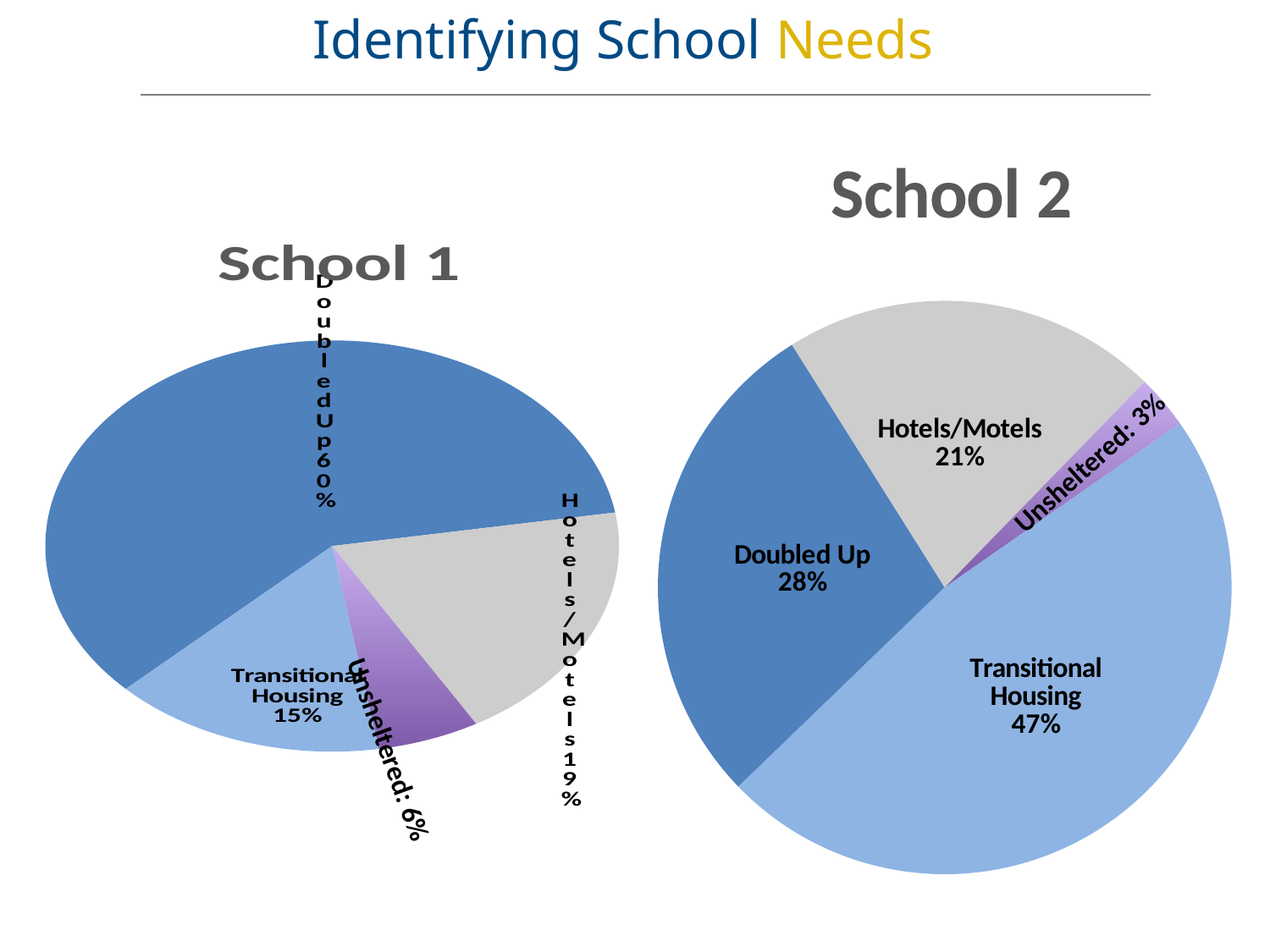
In the School 2 chart, what is the difference between Transitional Housing and Hotels/Motels? 26% What kind of chart is the School 1 chart? Pie chart In the School 1 chart, which category has the smallest slice? Unsheltered In the School 1 chart, what is the value for Hotels/Motels? 19% What is the title of the chart on the right side of the slide? School 2 In the School 1 chart, what share of the pie is Doubled Up? 60% Which is larger in the School 1 chart: Hotels/Motels or Transitional Housing? Hotels/Motels In the School 2 chart, what is the value for Doubled Up? 28% How many categories does the School 2 chart show? 4 In the School 1 chart, what is the value for Transitional Housing? 15% In the School 2 chart, which category has the largest slice? Transitional Housing In the School 2 chart, what is the value for Unsheltered? 3%